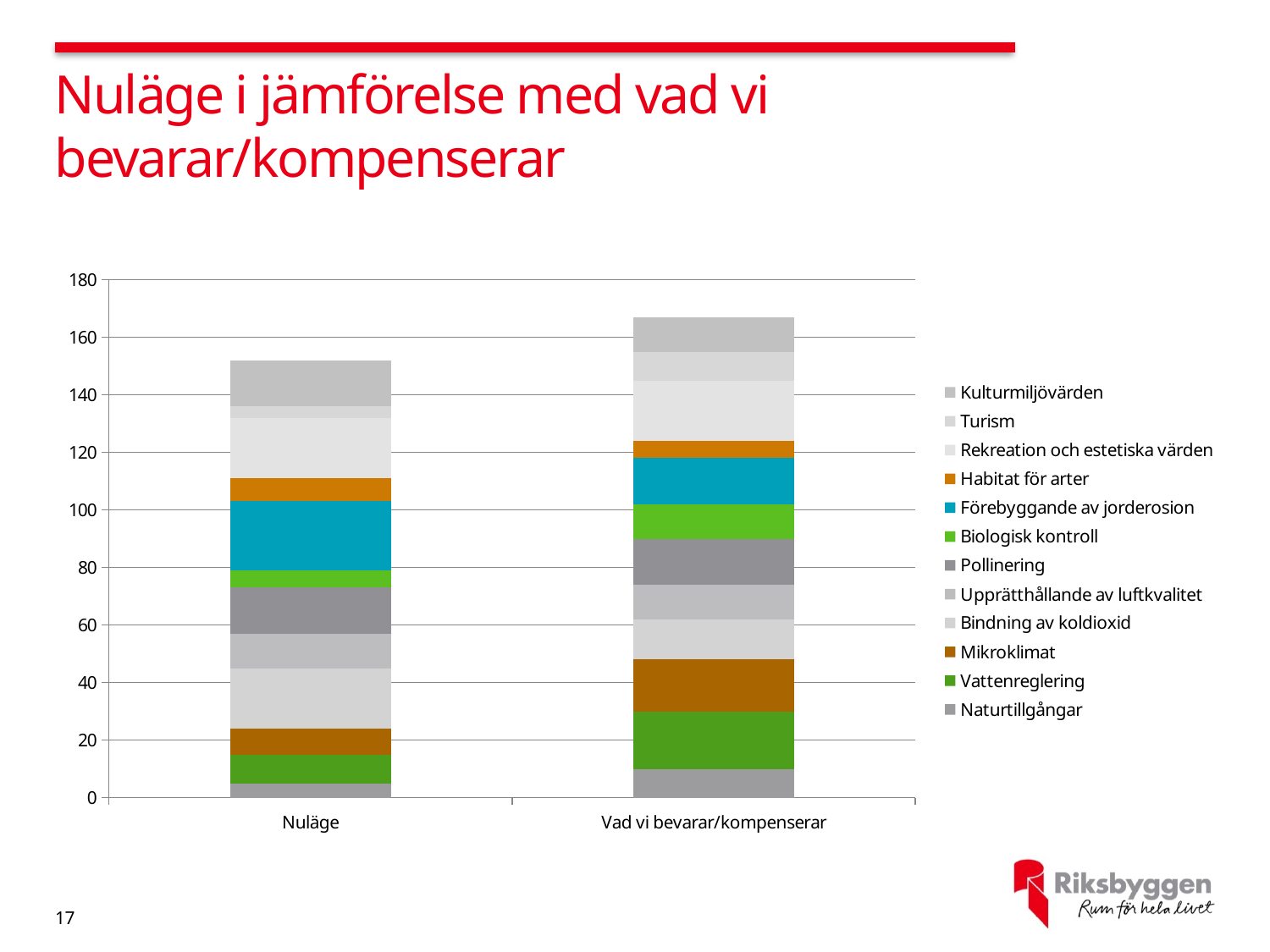
Is the total of the Nuläge bar greater or less than 160? less Is the total of the Nuläge bar greater or less than 140? greater What kind of chart is shown on the slide? Stacked bar chart How many series does the chart's legend list? 12 In which bar is the Mikroklimat segment larger, Nuläge or Vad vi bevarar/kompenserar? Vad vi bevarar/kompenserar Which series is listed first in the chart's legend? Kulturmiljövärden How many categories are shown on the x axis of the chart? 2 Which bar is taller, Nuläge or Vad vi bevarar/kompenserar? Vad vi bevarar/kompenserar In which bar is the Förebyggande av jorderosion segment larger, Nuläge or Vad vi bevarar/kompenserar? Nuläge Is the total of the Vad vi bevarar/kompenserar bar greater or less than 180? less Which series forms the bottom segment of each stacked bar? Naturtillgångar